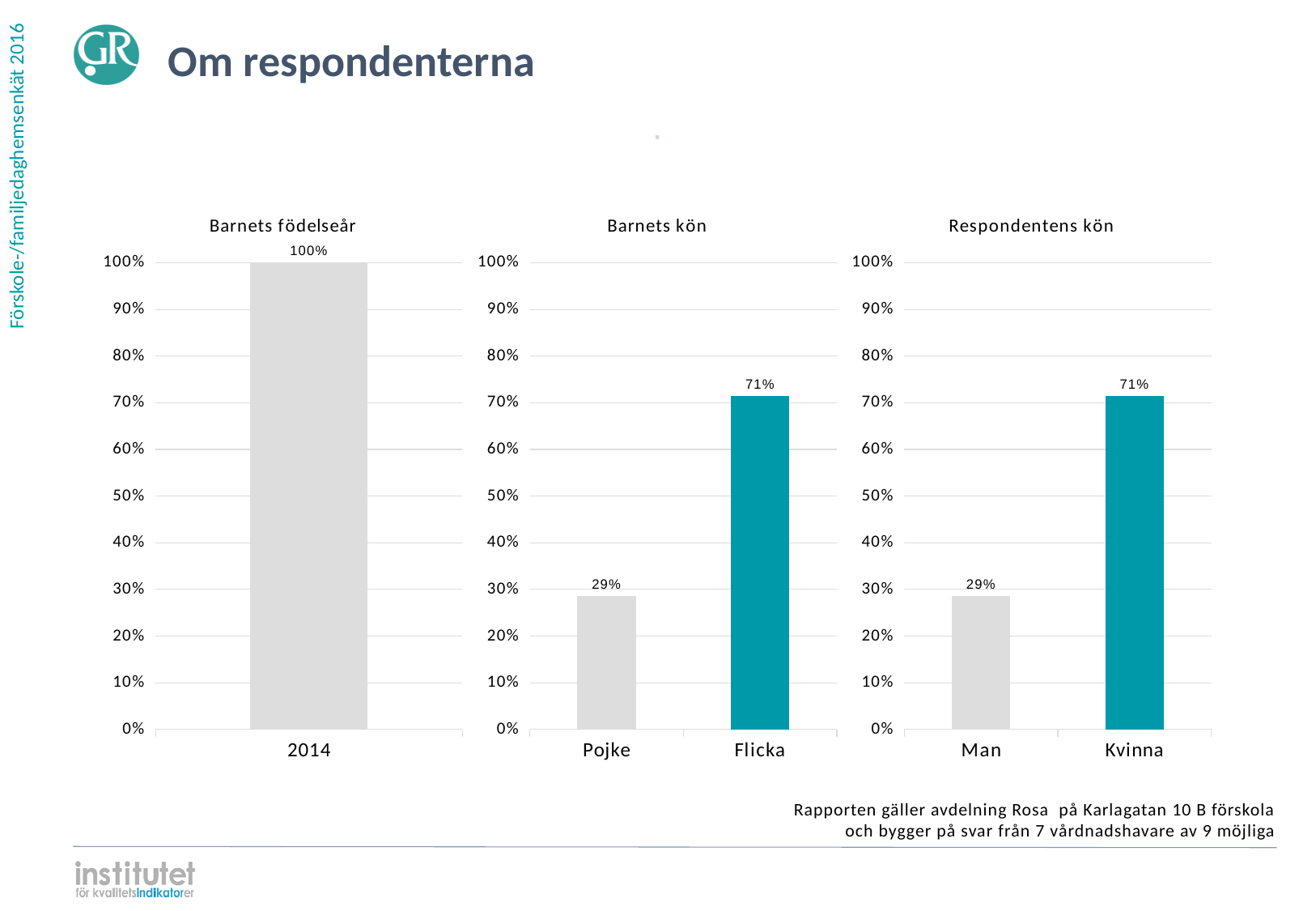
In the 'Barnets kön' chart, what is the difference between Flicka and Pojke? 42% What kind of chart is the 'Respondentens kön' chart? Bar chart How many charts are shown on the slide? 3 In the 'Respondentens kön' chart, what is the value for Kvinna? 71% In the 'Respondentens kön' chart, what is the value for Man? 29% In the 'Barnets kön' chart, what is the value for Flicka? 71% In the 'Barnets kön' chart, which category has the highest value? Flicka In the 'Respondentens kön' chart, which is larger, Man or Kvinna? Kvinna In the 'Barnets kön' chart, what is the value for Pojke? 29% In the 'Barnets födelseår' chart, what is the value for 2014? 100% How many categories are shown in the 'Barnets födelseår' chart? 1 In the 'Respondentens kön' chart, which category has the lowest value? Man